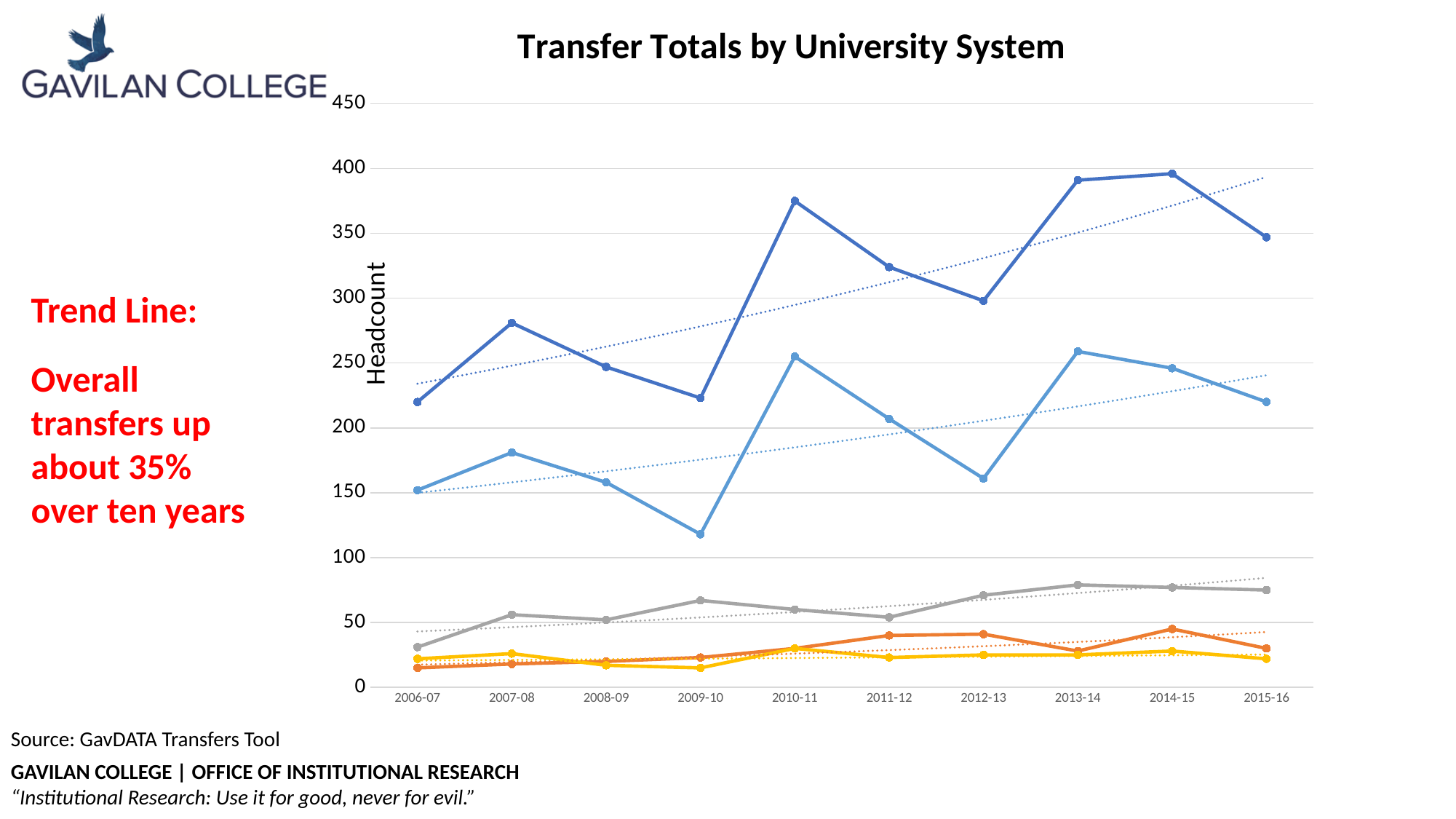
Is the value of the gray line in 2013-14 greater or less than 50? greater How many academic years are shown along the x axis of the chart? 10 Is the value of the dark blue line in 2009-10 greater or less than 250? less What is the title of the chart? Transfer Totals by University System How many solid data lines are plotted on the chart? 5 What is the label on the vertical axis of the chart? Headcount In 2010-11, which line has the larger value, the dark blue line or the light blue line? dark blue line Is the value of the dark blue line in 2010-11 greater or less than 350? greater In which year does the light blue line reach its lowest value? 2009-10 What kind of chart is shown on the slide? line chart Does the dark blue line rise or fall from 2014-15 to 2015-16? fall